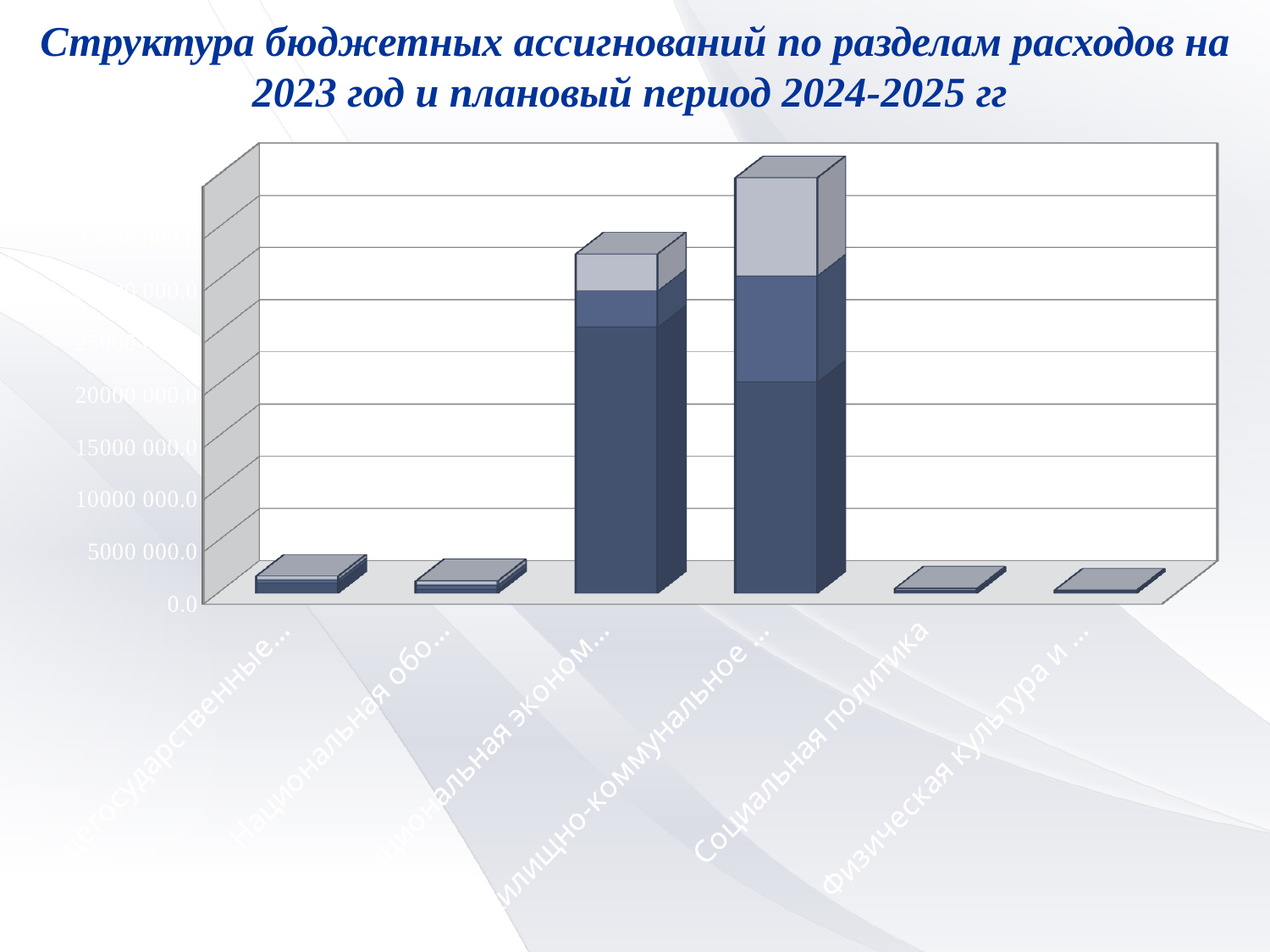
Which bar is taller: Жилищно-коммунальное ... or Национальная эконом...? Жилищно-коммунальное ... Is the total value of the bar for Социальная политика greater or less than 5000 000.0? less Which bar is taller: Общегосударственные... or Национальная эконом...? Национальная эконом... Which category has the tallest bar in the chart? Жилищно-коммунальное ... Is the total value of the bar for Жилищно-коммунальное ... greater or less than 20000 000.0? greater How many stacked segments does the tallest bar in the chart have? 3 Do the bar totals rise steadily from left to right across the categories? No How many categories are shown along the x axis of the chart? 6 Is the total value of the bar for Национальная эконом... greater or less than 20000 000.0? greater What kind of chart is shown on the slide? Stacked bar chart What is the title of the chart on the slide? Структура бюджетных ассигнований по разделам расходов на 2023 год и плановый период 2024-2025 гг